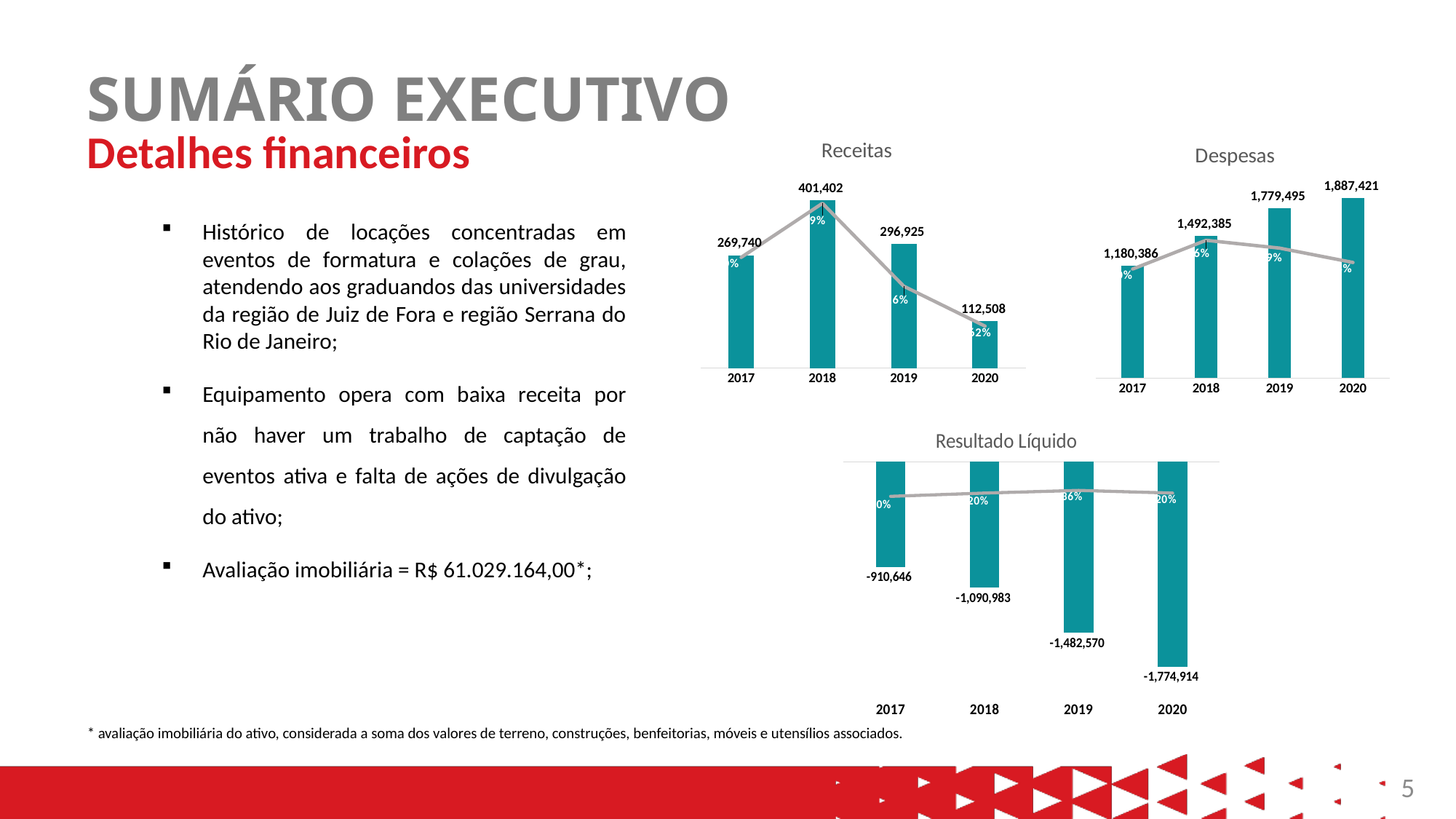
In the Resultado Líquido chart, which year has the lowest (most negative) value? 2020 In the Receitas chart, which is larger, the value for 2019 or the value for 2020? 2019 In the Despesas chart, do the bar values rise or fall from 2017 to 2020? rise How many years are shown on the x axis of the Resultado Líquido chart? 4 In the Receitas chart, which year has the lowest value? 2020 In the Despesas chart, which year has the highest value? 2020 What kind of chart is the Despesas chart? bar chart with a line overlay In the Resultado Líquido chart, what is the value for 2019? -1,482,570 In the Despesas chart, what is the difference between the 2020 and 2019 values? 107,926 In the Despesas chart, what is the value for 2017? 1,180,386 In the Receitas chart, what is the value for 2018? 401,402 In the Receitas chart, what is the difference between the 2018 and 2017 values? 131,662